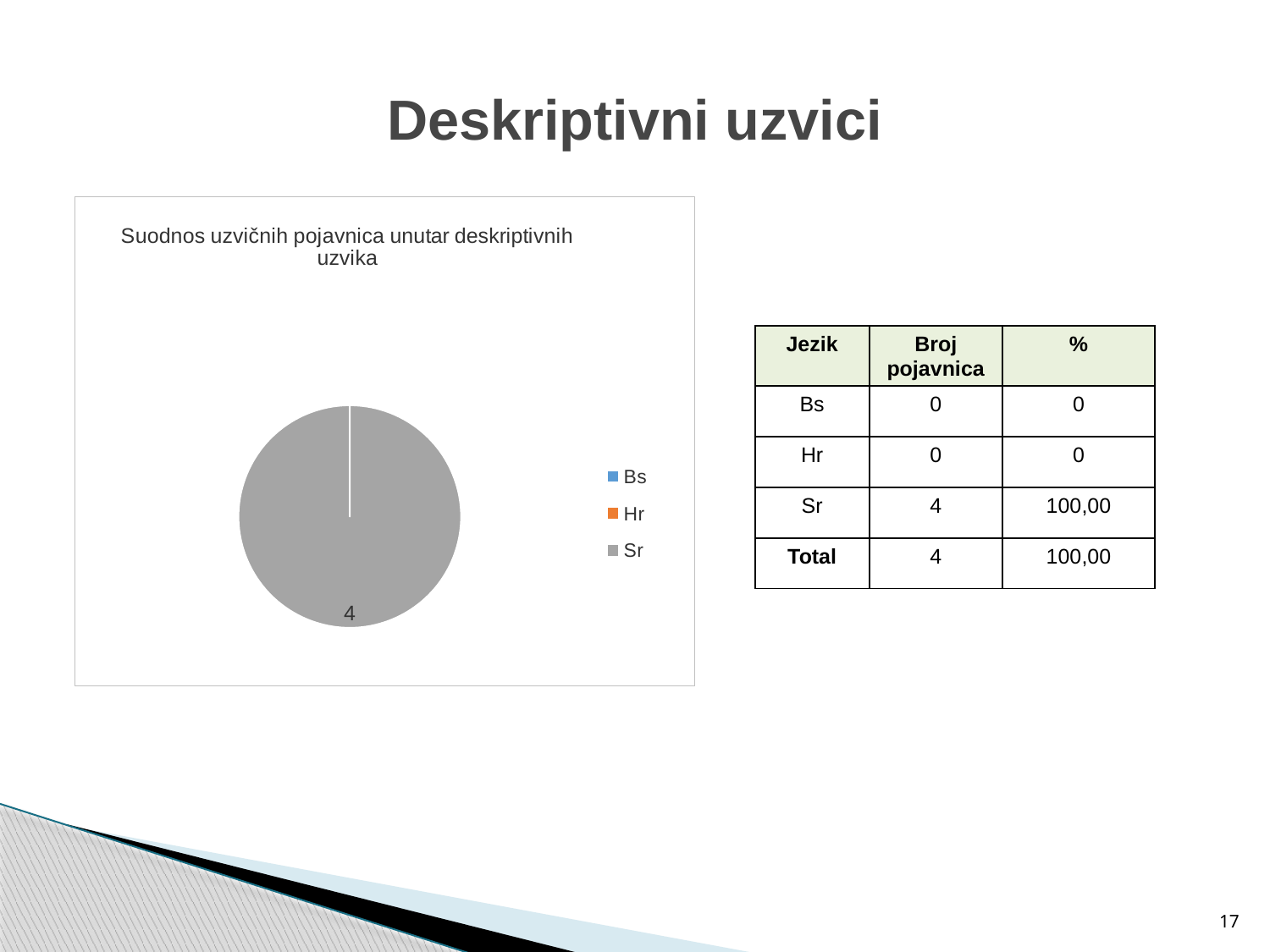
What is the difference between the values for Sr and Bs? 4 Which legend entries are listed in the chart? Bs, Hr, Sr According to the table, what is the Broj pojavnica value for Hr? 0 What type of chart is shown on the slide? pie chart What share of the pie does the Sr slice represent? 100,00 What value is printed on the Sr slice of the pie chart? 4 Which category has the largest slice in the pie chart? Sr According to the table, what is the Broj pojavnica value for Bs? 0 What is the title of the chart? Suodnos uzvičnih pojavnica unutar deskriptivnih uzvika Which is larger, the value for Sr or the value for Hr? Sr How many entries does the chart legend list? 3 According to the table, what is the Total Broj pojavnica? 4